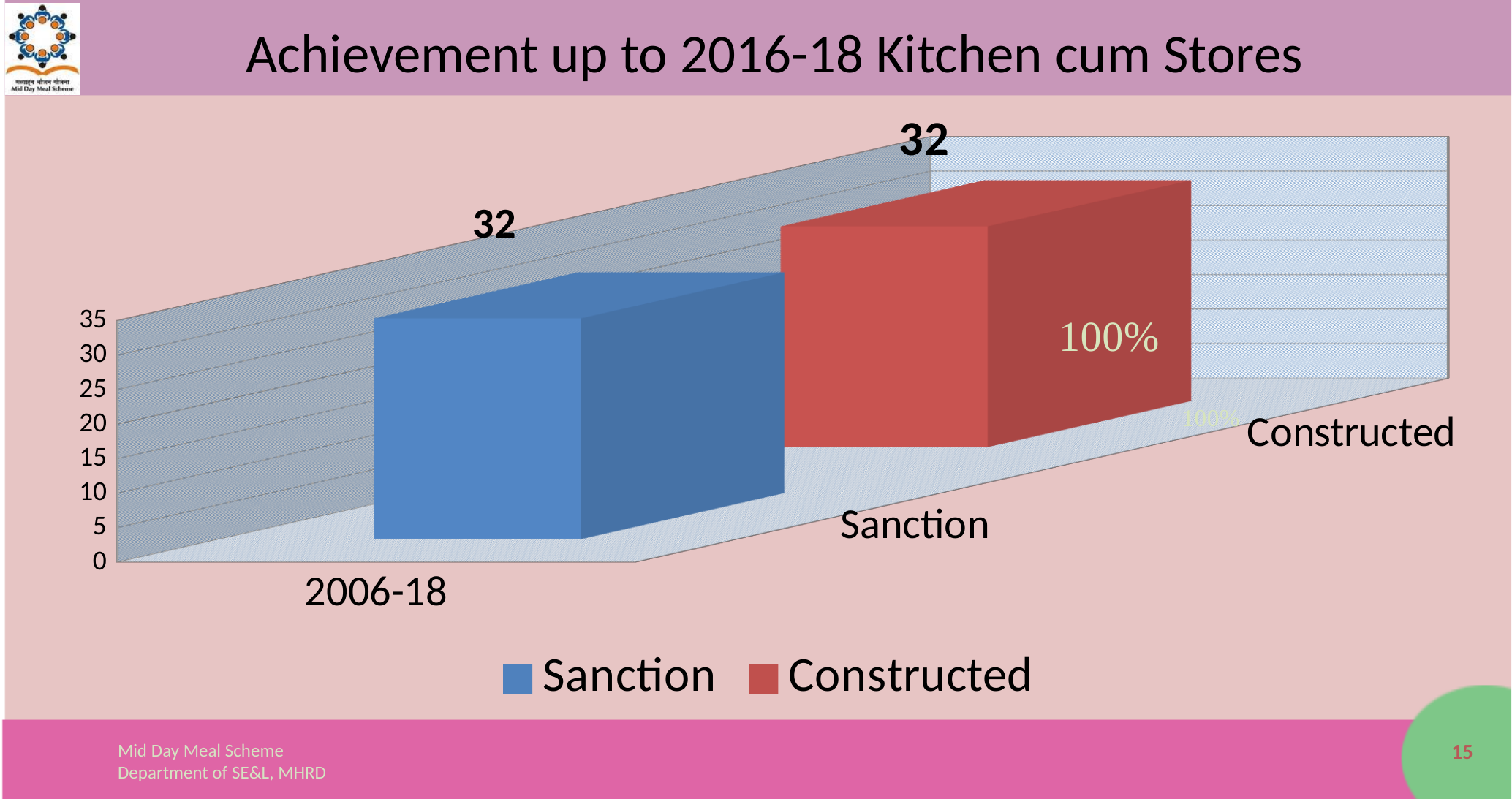
How many categories are shown on the x axis? 1 Is the value for Sanction greater or less than 30? greater Which colour represents the Constructed series? red What is the value for Sanction in 2006-18? 32 What is the value for Constructed in 2006-18? 32 Is the value for Constructed greater or less than 35? less What is the title of the chart? Achievement up to 2016-18 Kitchen cum Stores What is the difference between the Sanction and Constructed values for 2006-18? 0 What kind of chart is shown on the slide? bar chart How many series does the legend list? 2 What percentage label is shown on the Constructed bar? 100% What is the highest value shown on the vertical axis? 35